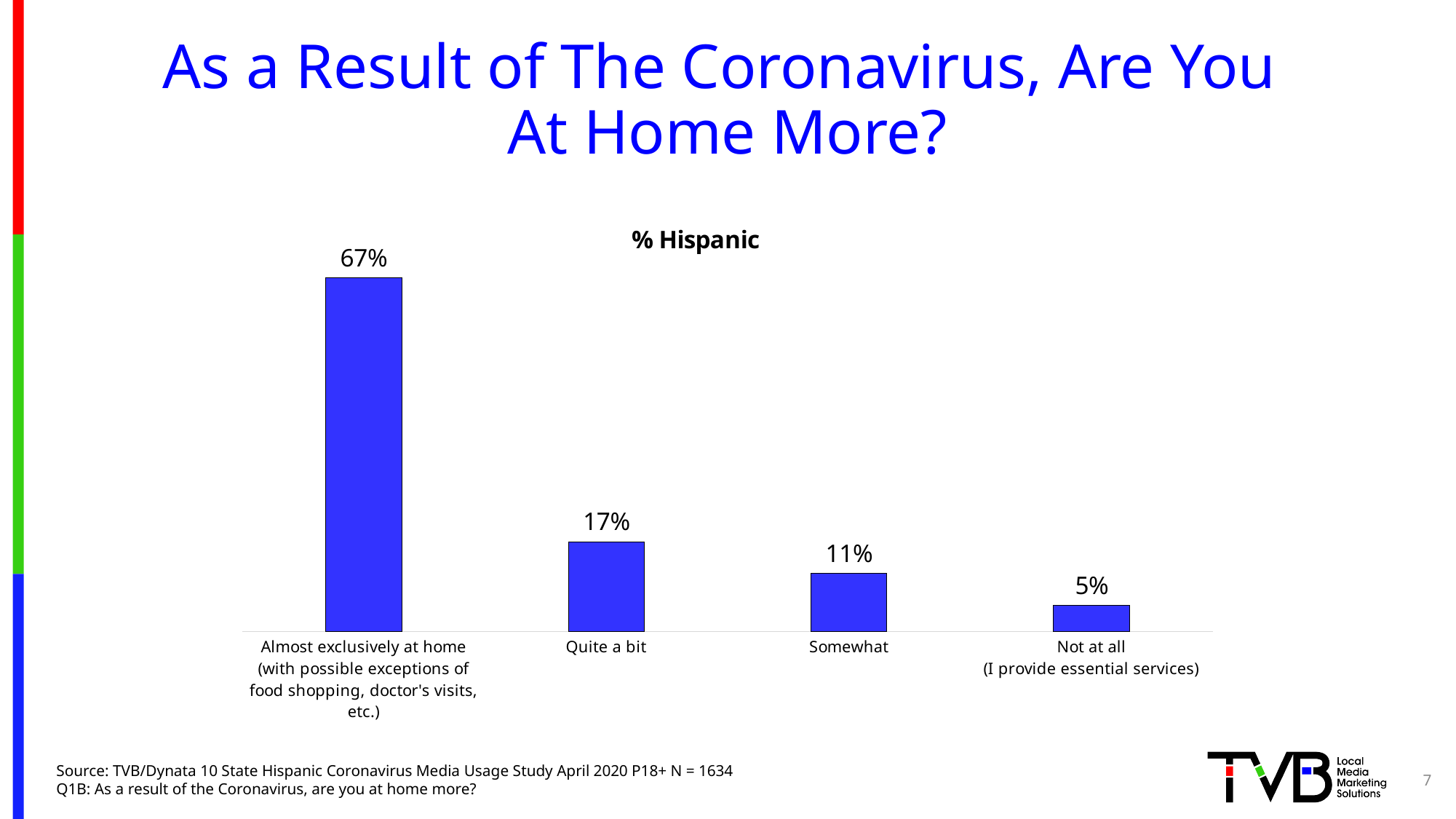
What is the value for the "Quite a bit" category? 17% What percentage of Hispanic respondents said they are almost exclusively at home? 67% What is the difference between the "Somewhat" value and the "Not at all" value? 6 percentage points What percentage said "Not at all (I provide essential services)"? 5% Which category has the highest value? Almost exclusively at home Which is larger, the value for "Quite a bit" or the value for "Somewhat"? Quite a bit What is the value for the "Somewhat" category? 11% What is the title of the chart? % Hispanic What kind of chart is shown on the slide? Bar chart How many categories are shown in the chart? 4 What is the difference between the "Almost exclusively at home" value and the "Quite a bit" value? 50 percentage points Which category has the lowest value? Not at all (I provide essential services)